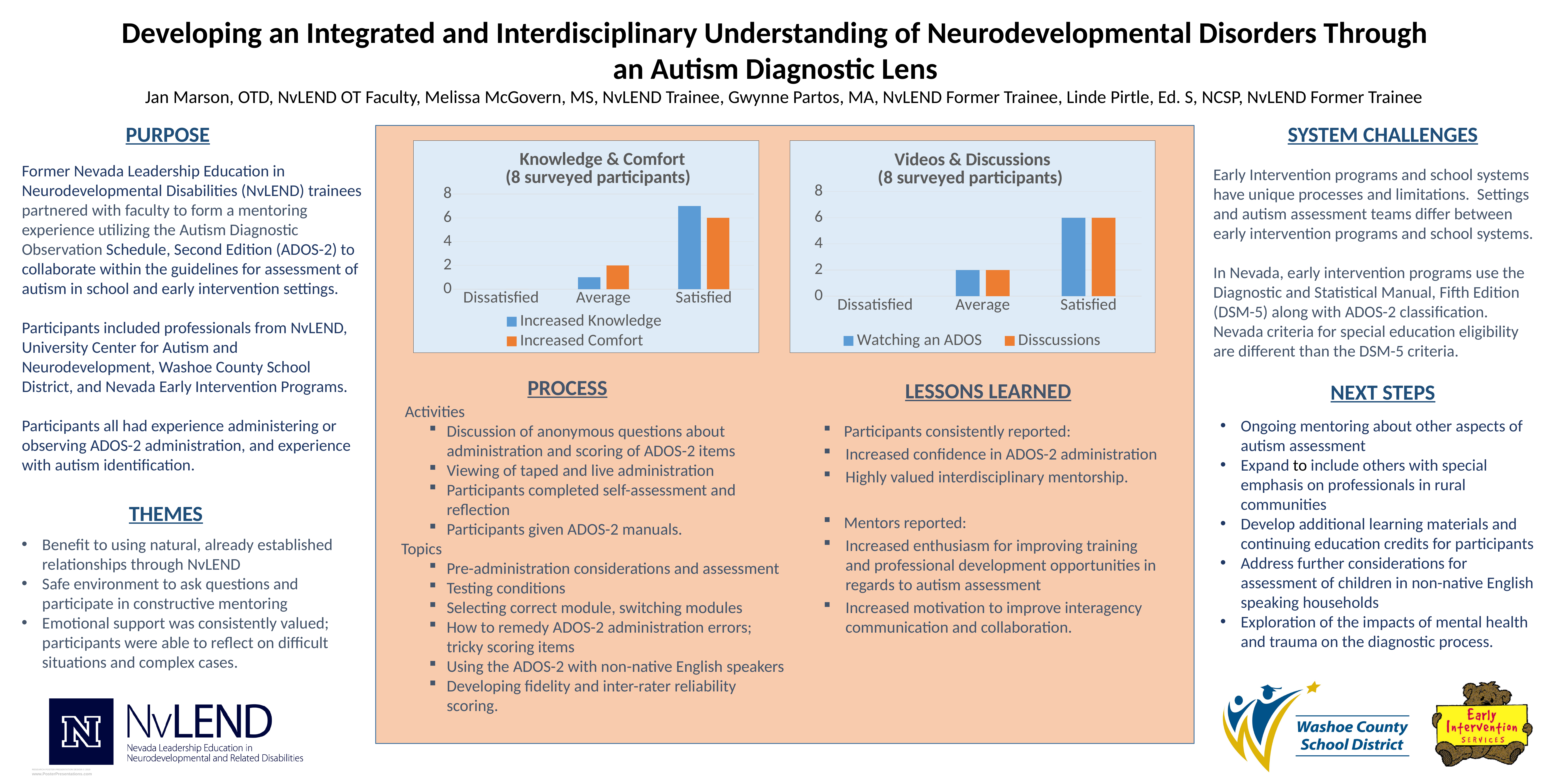
How many surveyed participants does the title of the 'Videos & Discussions' chart mention? 8 In the 'Knowledge & Comfort' chart, which category has the highest value for Increased Knowledge? Satisfied In the 'Knowledge & Comfort' chart, which is larger at Satisfied: Increased Knowledge or Increased Comfort? Increased Knowledge In the 'Knowledge & Comfort' chart, is the value for Increased Knowledge at Satisfied greater or less than 6? greater In the 'Knowledge & Comfort' chart, what is the value for Increased Comfort at Average? 2 How many series does the legend of the 'Knowledge & Comfort' chart list? 2 How many categories are shown on the x axis of the 'Videos & Discussions' chart? 3 In the 'Videos & Discussions' chart, what is the value for Watching an ADOS at Satisfied? 6 In the 'Videos & Discussions' chart, what is the difference between the Watching an ADOS values at Satisfied and Average? 4 In the 'Videos & Discussions' chart, do the Disscussions values rise or fall from Dissatisfied to Satisfied? rise In the 'Videos & Discussions' chart, what is the value for Disscussions at Average? 2 What kind of chart is the 'Knowledge & Comfort' chart? bar chart